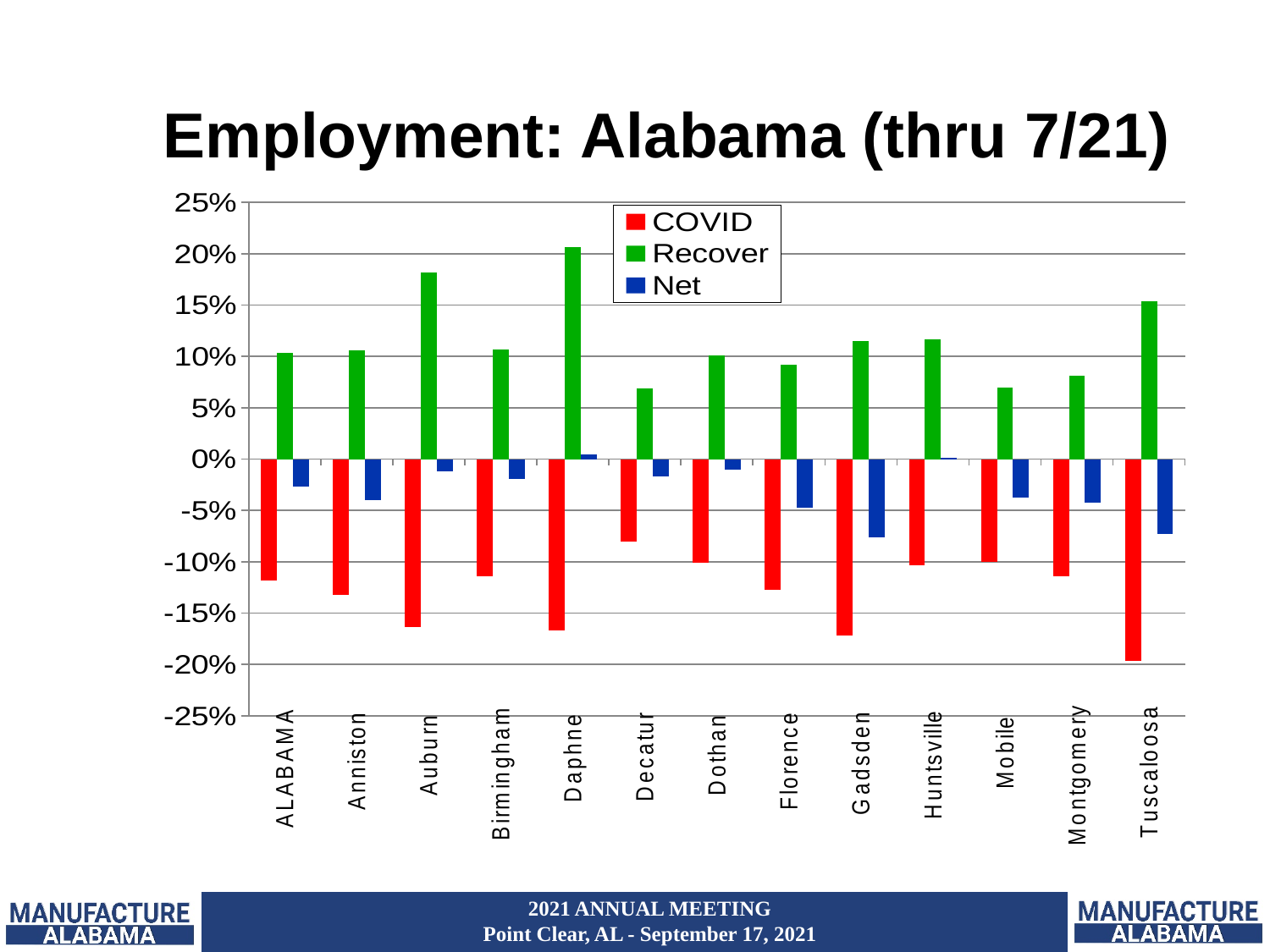
Is the COVID value for Tuscaloosa greater or less than -15%? less Which category has the lowest (most negative) COVID value? Tuscaloosa How many categories are shown on the x axis? 13 Is the Recover value for Mobile greater or less than 10%? less What kind of chart is shown on the slide? bar chart How many series does the legend list? 3 Is the Net value for Gadsden greater or less than -5%? less Which has the larger (less negative) COVID value, Decatur or Gadsden? Decatur Which has the larger Recover value, Auburn or Birmingham? Auburn What is the title of the chart? Employment: Alabama (thru 7/21) Which category has the highest Recover value? Daphne